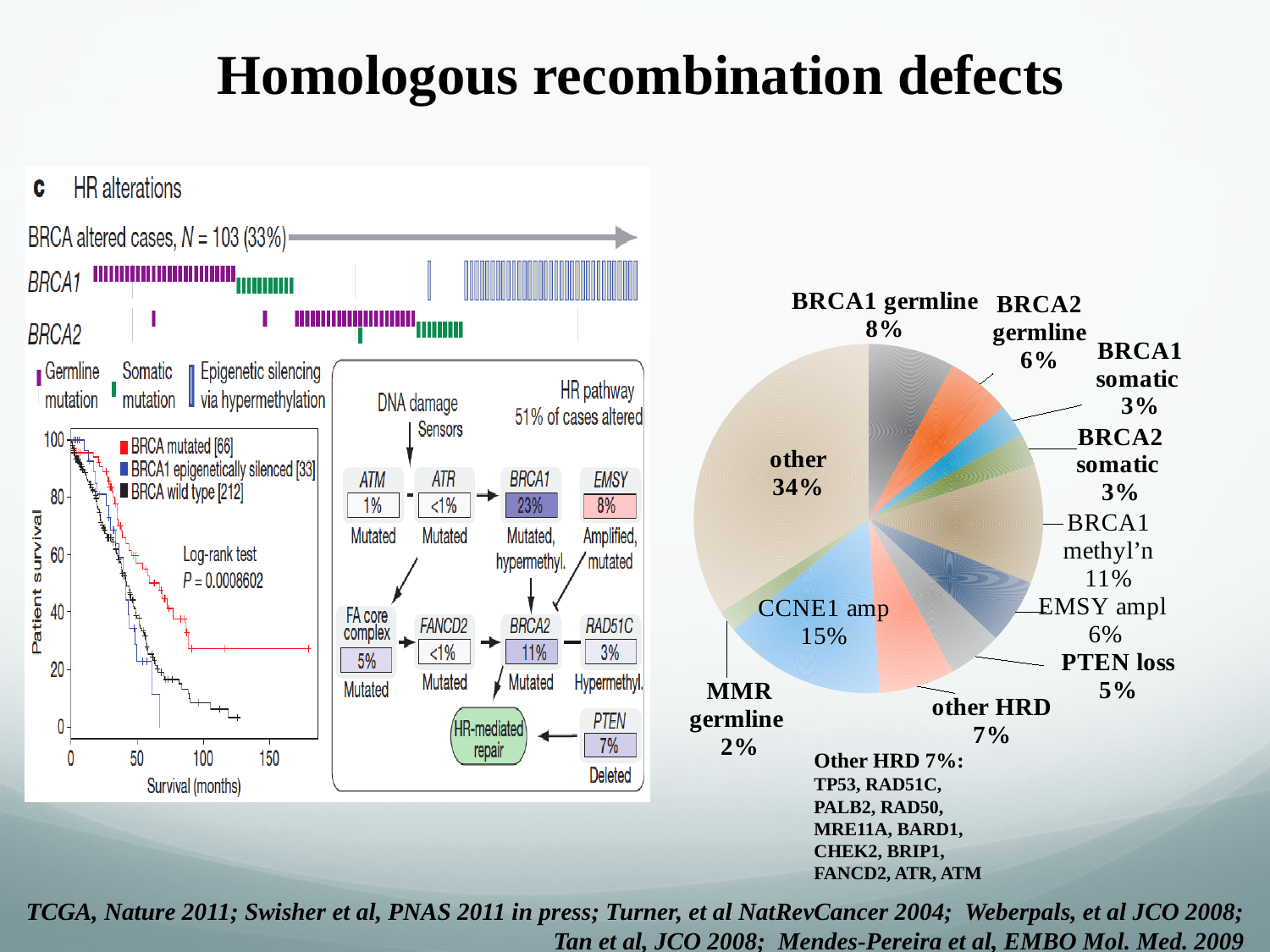
In the pie chart on the right, which slice has the largest share? other What is the y-axis label of the survival curve chart on the left of the slide? Patient survival In the pie chart on the right, what percentage is shown for MMR germline? 2% In the pie chart on the right, what share is labelled for CCNE1 amp? 15% What kind of chart is shown on the right side of the slide? pie chart In the pie chart on the right, which is larger: the share for PTEN loss or the share for other HRD? other HRD In the pie chart on the right, what is the difference between the BRCA1 germline share and the BRCA2 germline share? 2% In the pie chart on the right, what percentage is shown for BRCA1 methyl'n? 11% In the pie chart on the right, which slice has the smallest share? MMR germline In the pie chart on the right, how many slices are labelled? 11 In the pie chart on the right, what percentage is shown for EMSY ampl? 6% In the pie chart on the right, what is the combined share of BRCA1 somatic and BRCA2 somatic? 6%